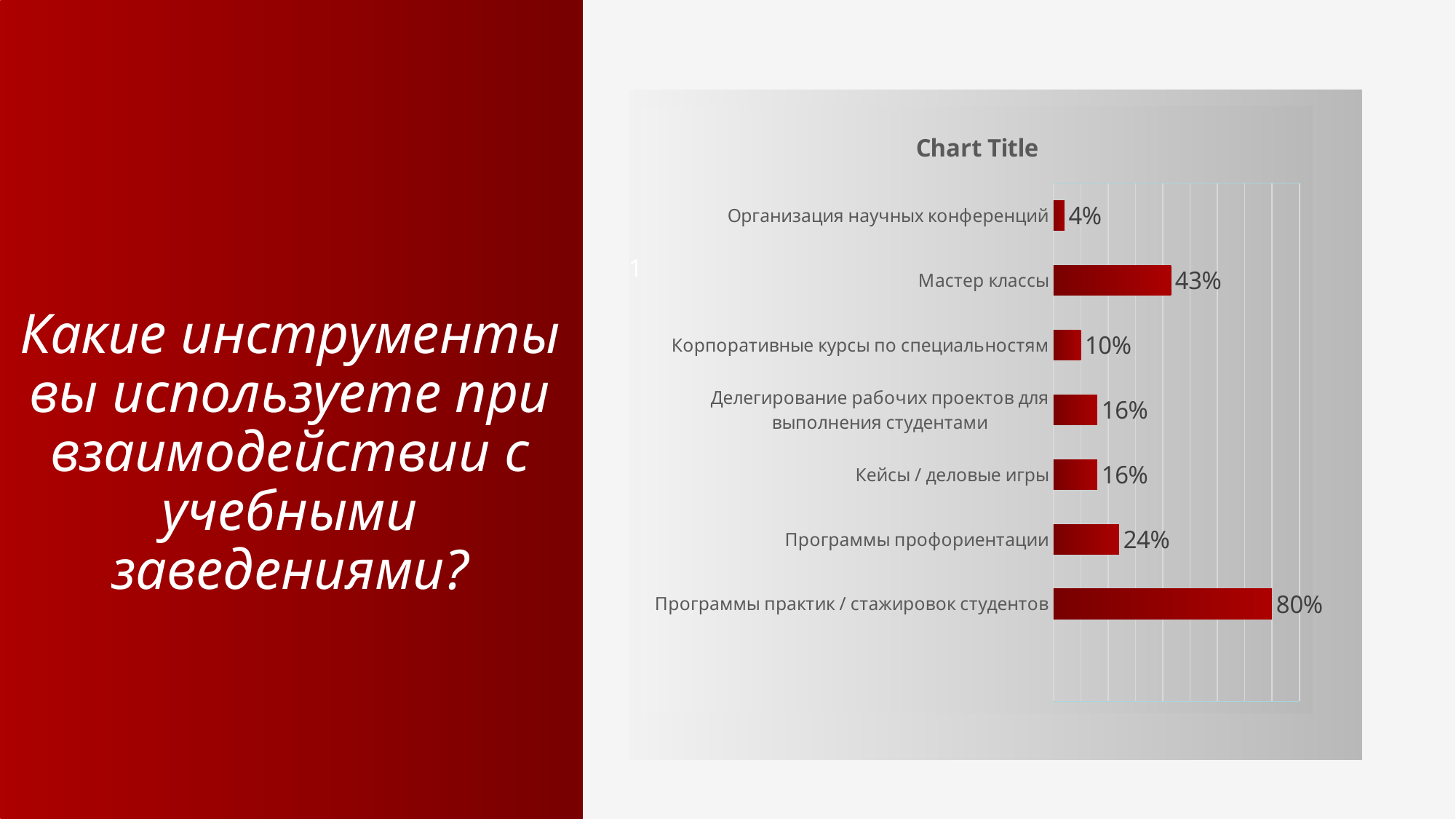
What is the title of the chart? Chart Title What is the value for Мастер классы? 43% What kind of chart is shown on the slide? Bar chart What is the value for Программы профориентации? 24% Which category has the lowest value? Организация научных конференций Which category has the highest value? Программы практик / стажировок студентов What is the difference between the values for Программы профориентации and Кейсы / деловые игры? 8% Which is larger, the value for Корпоративные курсы по специальностям or the value for Программы профориентации? Программы профориентации What is the value for Организация научных конференций? 4% How many categories are shown in the chart? 7 What is the value for Программы практик / стажировок студентов? 80% What is the difference between the values for Программы практик / стажировок студентов and Мастер классы? 37%